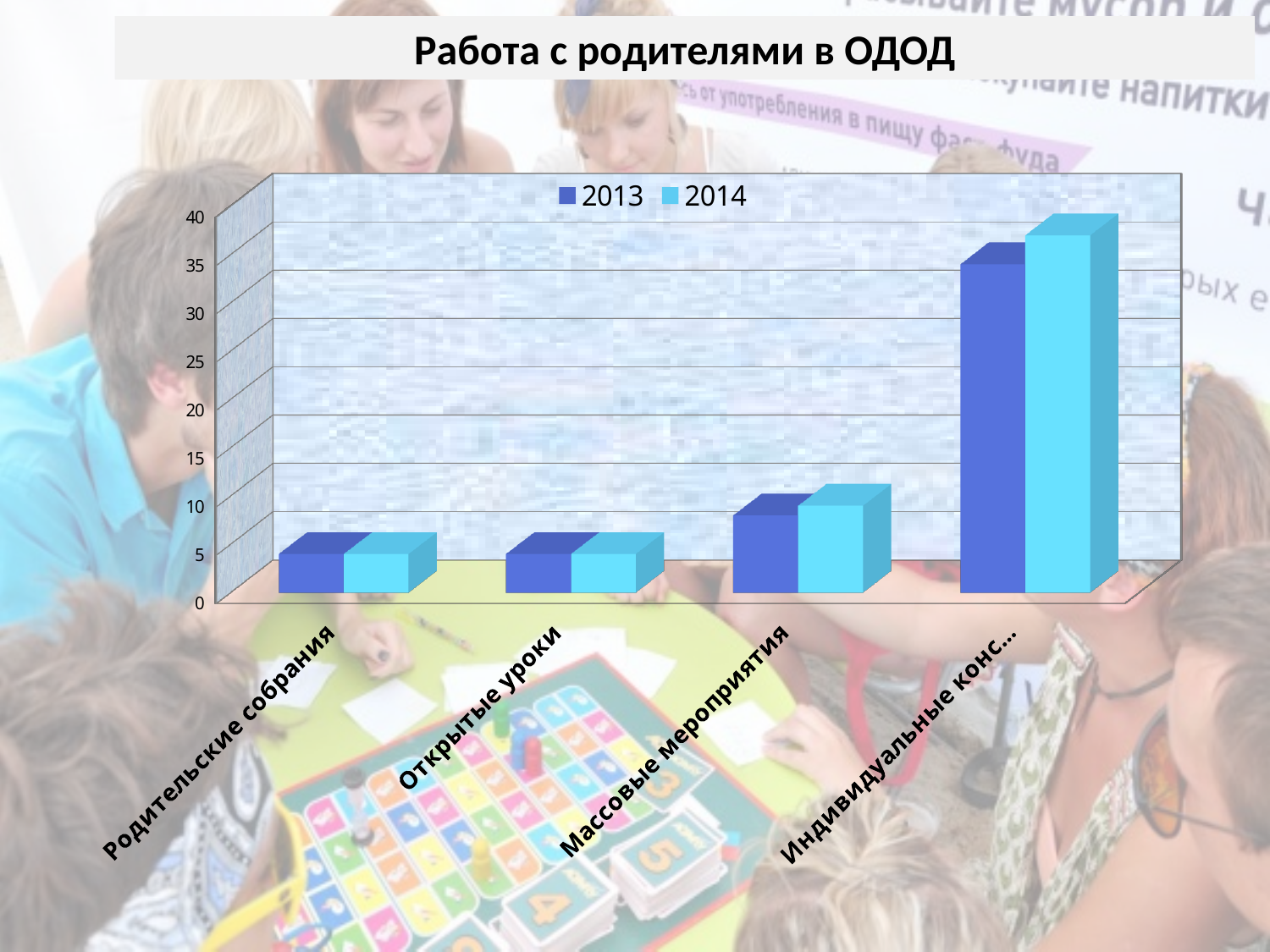
Which category has the highest value for 2013? Индивидуальные конс... How many series does the legend list? 2 Is the 2013 value for Массовые мероприятия greater or less than 10? less Which category has the highest value for 2014? Индивидуальные конс... For Массовые мероприятия, which year has the larger value, 2013 or 2014? 2014 Is the 2013 value for Индивидуальные конс... greater or less than 30? greater What type of chart is shown on the slide? bar chart Which is larger for 2013: Массовые мероприятия or Открытые уроки? Массовые мероприятия What is the title of the slide? Работа с родителями в ОДОД Which years are listed in the legend? 2013 and 2014 Is the 2014 value for Родительские собрания greater or less than 10? less How many categories are shown on the x axis? 4